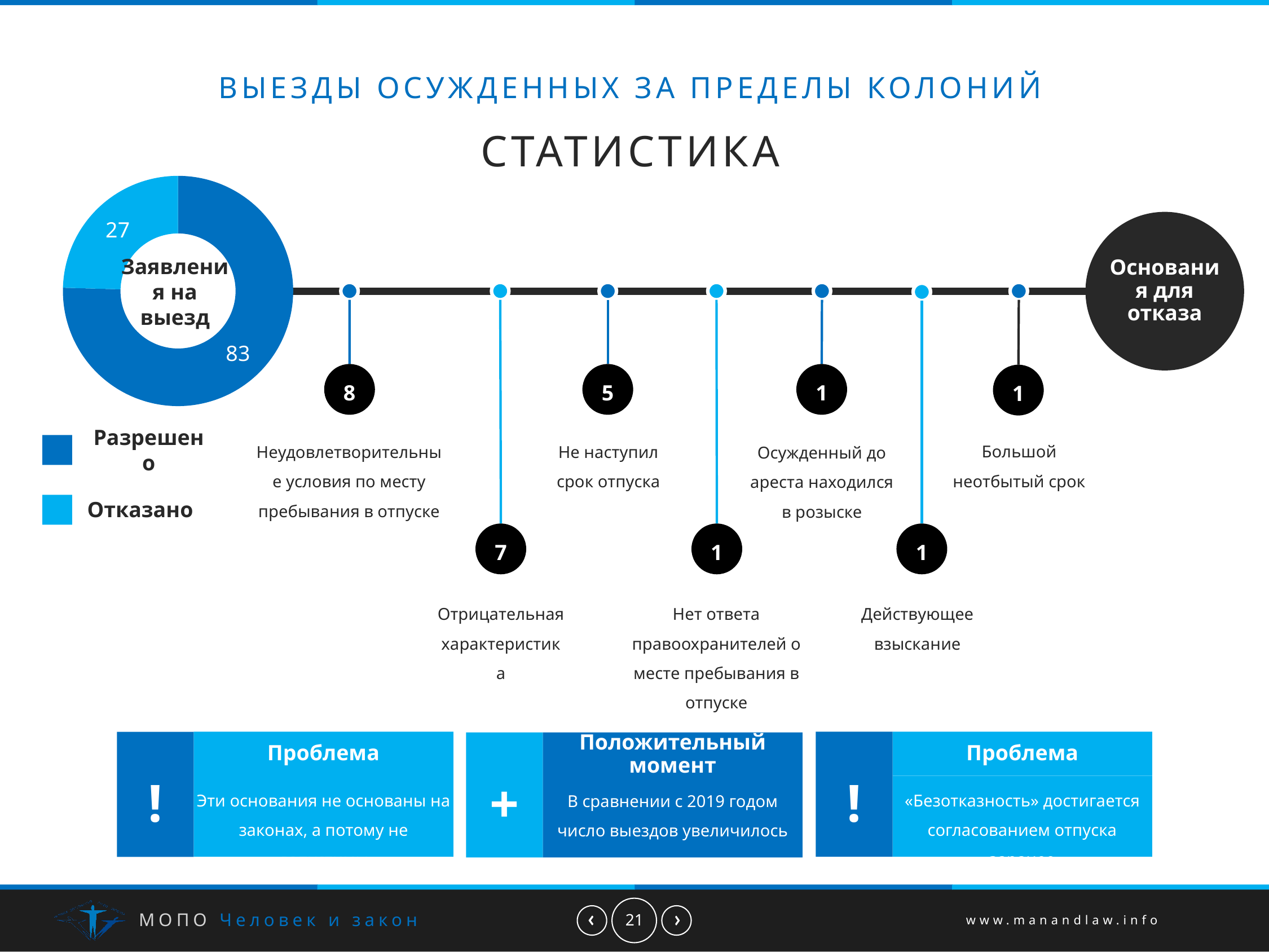
In the donut chart, which colour represents 'Отказано'? Light blue How many categories does the donut chart 'Заявления на выезд' show? 2 In the donut chart 'Заявления на выезд', which category has the largest value? Разрешено What kind of chart is the chart on the left of the slide? Donut (pie) chart In the timeline 'Основания для отказа', what is the number shown for 'Неудовлетворительные условия по месту пребывания в отпуске'? 8 In the donut chart 'Заявления на выезд', which category has the smallest value? Отказано What is the title shown in the centre of the donut chart? Заявления на выезд In the donut chart 'Заявления на выезд', what is the total of the two segments? 110 In the donut chart 'Заявления на выезд', what is the value for 'Отказано'? 27 In the donut chart 'Заявления на выезд', what is the value for 'Разрешено'? 83 In the donut chart 'Заявления на выезд', which is larger: 'Разрешено' or 'Отказано'? Разрешено In the donut chart 'Заявления на выезд', what is the difference between 'Разрешено' and 'Отказано'? 56